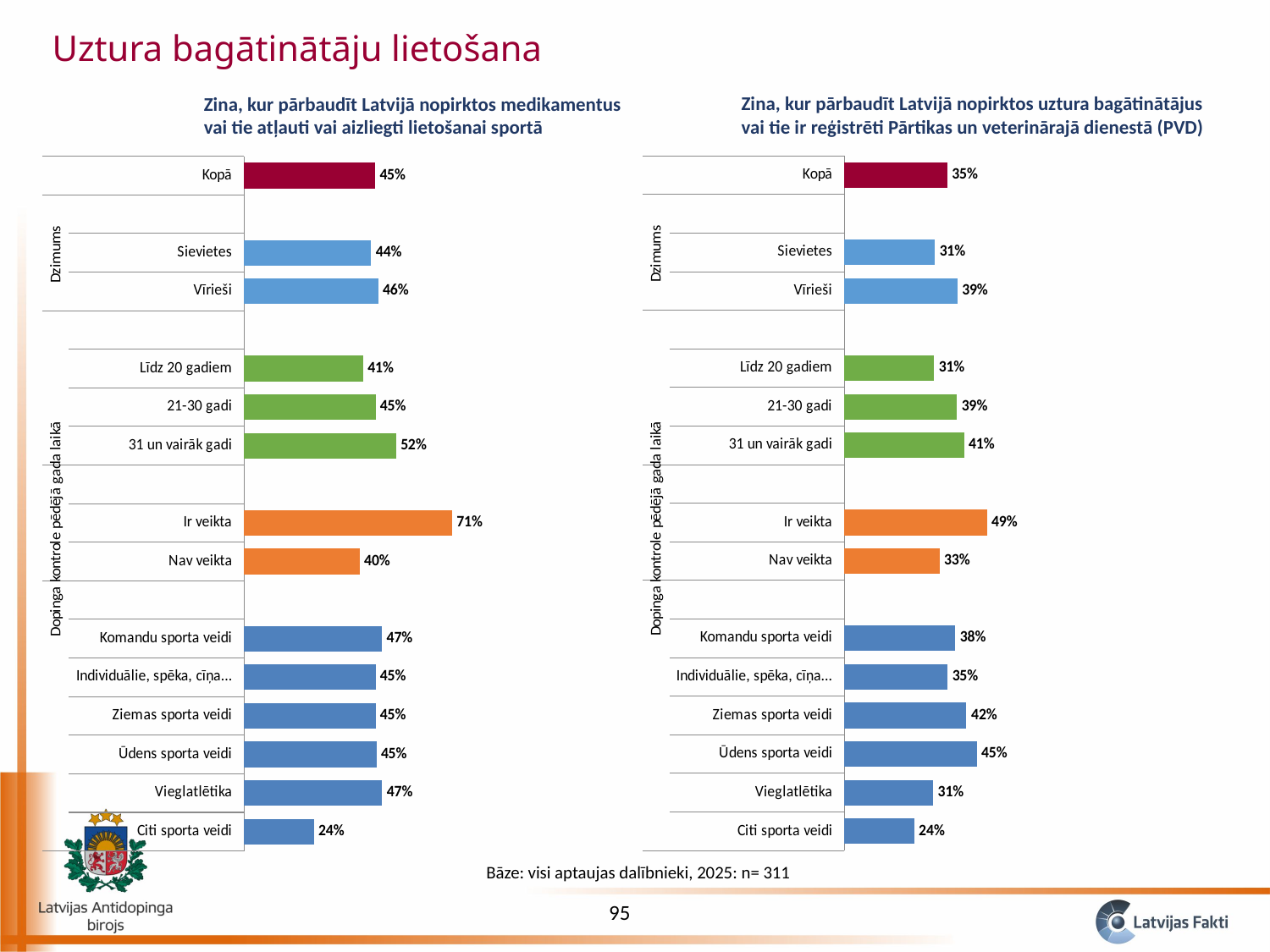
How many categories are plotted on the right chart? 14 On the right chart, what is the value for Ūdens sporta veidi? 45% On the right chart, what is the difference between 31 un vairāk gadi and Līdz 20 gadiem? 10 percentage points On the left chart, which category has the highest value? Ir veikta What type of chart is the left chart? Bar chart On the right chart, which is larger, Vīrieši or Sievietes? Vīrieši On the left chart, what is the difference between Ir veikta and Nav veikta? 31 percentage points On the right chart, which category has the lowest value? Citi sporta veidi On the left chart, which is larger, Komandu sporta veidi or Citi sporta veidi? Komandu sporta veidi On the left chart, what is the value for Kopā? 45% On the left chart, what is the value for 31 un vairāk gadi? 52% On the right chart, what is the value for Ir veikta? 49%